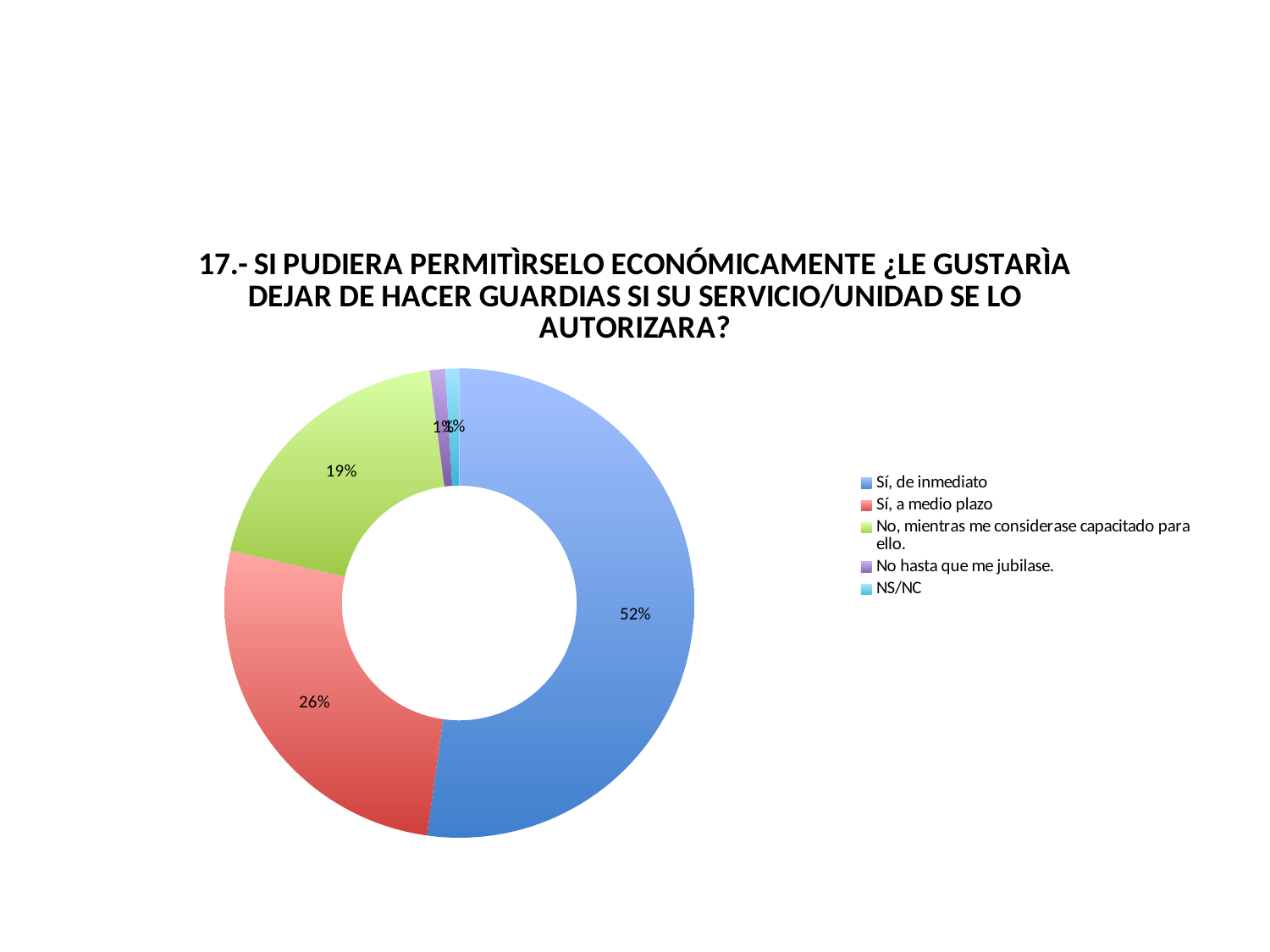
What type of chart is shown on the slide? Doughnut (pie) chart Which is larger: the share for "Sí, a medio plazo" or the share for "No, mientras me considerase capacitado para ello."? Sí, a medio plazo What share of the chart corresponds to "No, mientras me considerase capacitado para ello."? 19% What percentage of respondents answered "Sí, a medio plazo"? 26% Which colour represents "NS/NC" in the chart? Light blue (cyan) What is the difference in percentage points between "Sí, a medio plazo" and "No, mientras me considerase capacitado para ello."? 7 percentage points How many response categories does the legend list? 5 What is the difference in percentage points between "Sí, de inmediato" and "Sí, a medio plazo"? 26 percentage points Which response category has the largest share of the chart? Sí, de inmediato What is the question number shown at the start of the chart title? 17 What percentage of respondents answered "Sí, de inmediato"? 52%